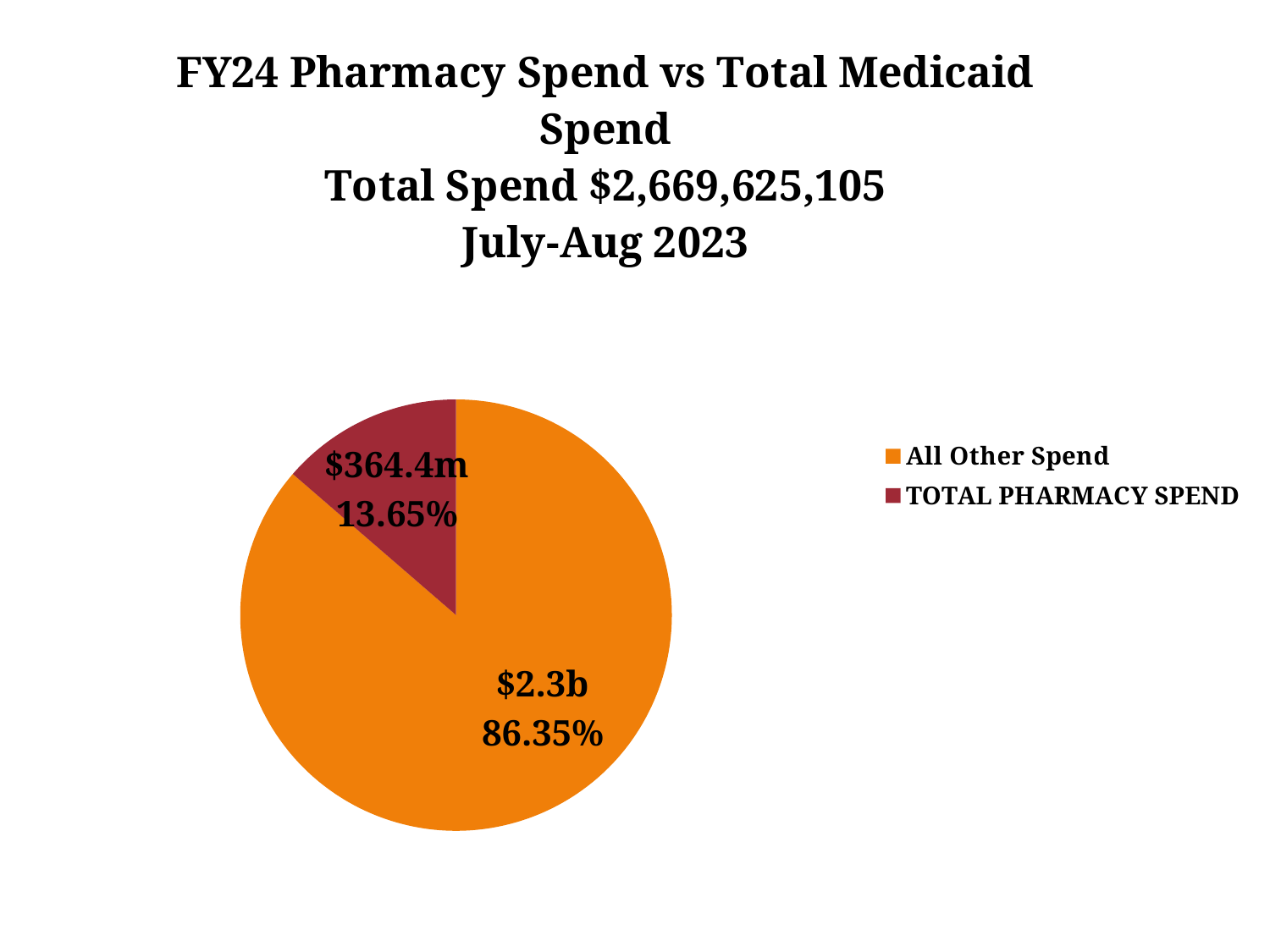
Which slice is the smallest? TOTAL PHARMACY SPEND How many slices does the pie chart have? 2 What share of the pie does All Other Spend represent? 86.35% What total spend is stated in the chart title? $2,669,625,105 What is the value shown for All Other Spend? $2.3b What kind of chart is shown on the slide? Pie chart Which is larger, All Other Spend or TOTAL PHARMACY SPEND? All Other Spend What is the value shown for TOTAL PHARMACY SPEND? $364.4m How many entries does the legend list? 2 What share of the pie does TOTAL PHARMACY SPEND represent? 13.65% What is the difference in percentage points between the All Other Spend share and the TOTAL PHARMACY SPEND share? 72.7 percentage points Which slice is the largest? All Other Spend